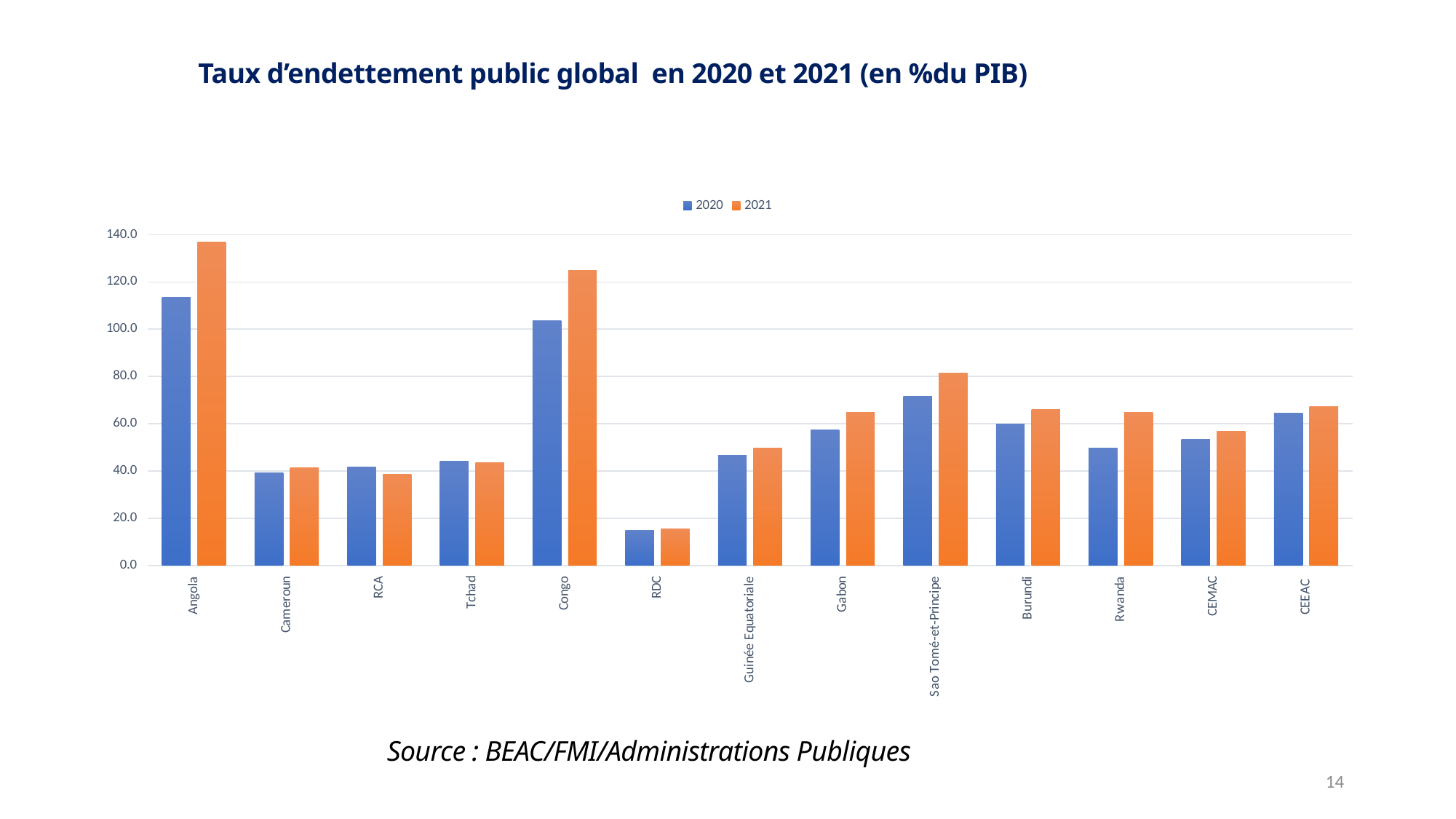
What kind of chart is shown on the slide? bar chart Is the value for RDC in 2020 greater or less than 20? less Is the value for Gabon in 2020 greater or less than 60? less Which is larger for Congo in 2021: Congo's value or Angola's value? Angola Which category has the lowest value for 2020? RDC How many series does the legend list? 2 How many countries or groupings are shown on the x axis? 13 What is the title of the chart? Taux d'endettement public global en 2020 et 2021 (en %du PIB) For Sao Tomé-et-Principe and Burundi, which has the larger value in 2020? Sao Tomé-et-Principe Is the value for Angola in 2021 greater or less than 120? greater Which category has the highest value for 2021? Angola